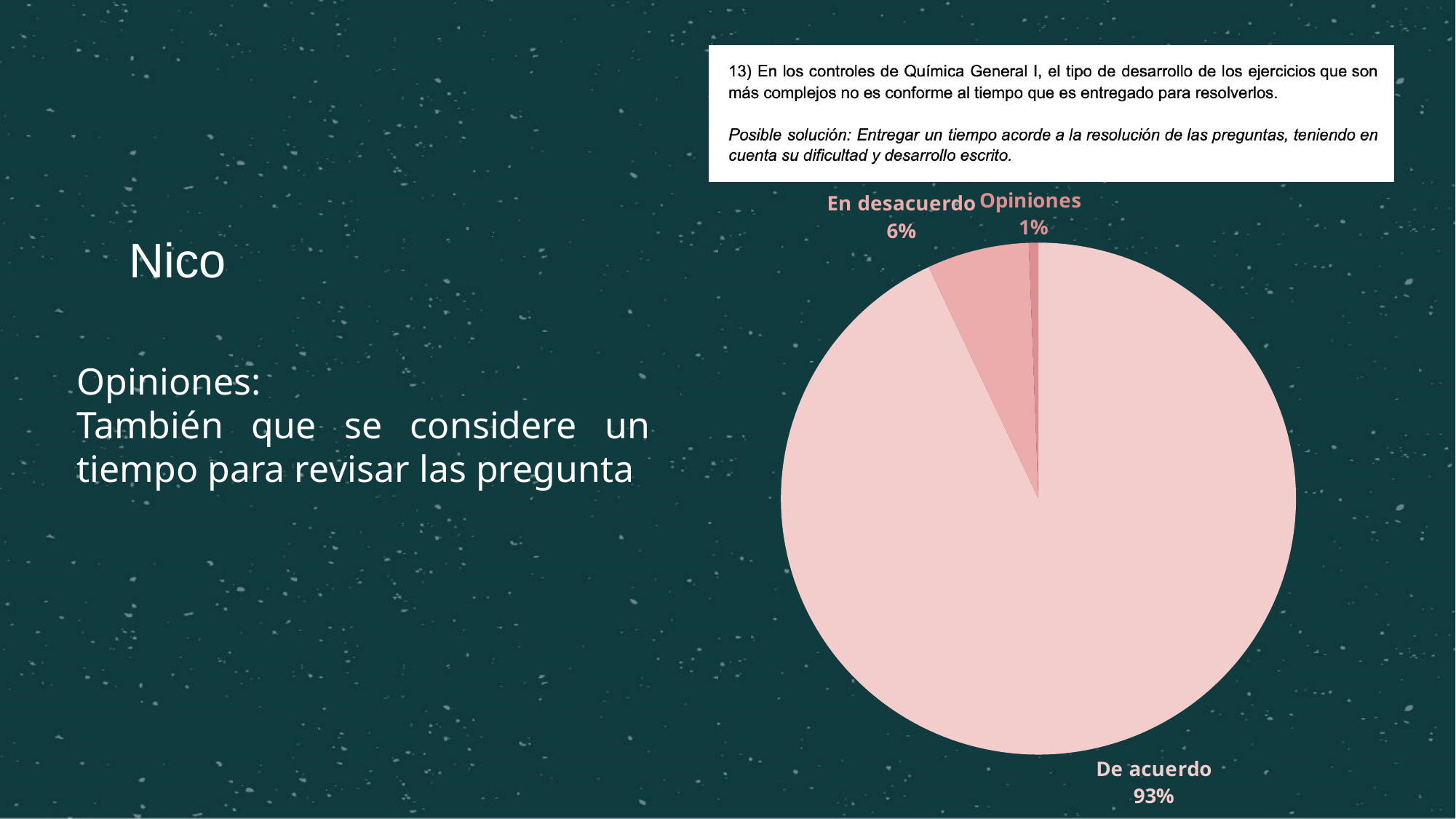
Which slice of the pie chart is the smallest? Opiniones How many slices does the pie chart have? 3 What percentage of the pie chart is labelled "En desacuerdo"? 6% Which is larger in the pie chart, "En desacuerdo" or "Opiniones"? En desacuerdo What percentage of the pie chart is labelled "De acuerdo"? 93% Which slice of the pie chart is drawn in the darkest shade of pink? Opiniones What is the combined share of the "En desacuerdo" and "Opiniones" slices? 7% What percentage of the pie chart is labelled "Opiniones"? 1% What kind of chart is shown on the slide? pie chart What is the difference in percentage points between the "De acuerdo" and "En desacuerdo" slices? 87 Which slice of the pie chart is the largest? De acuerdo